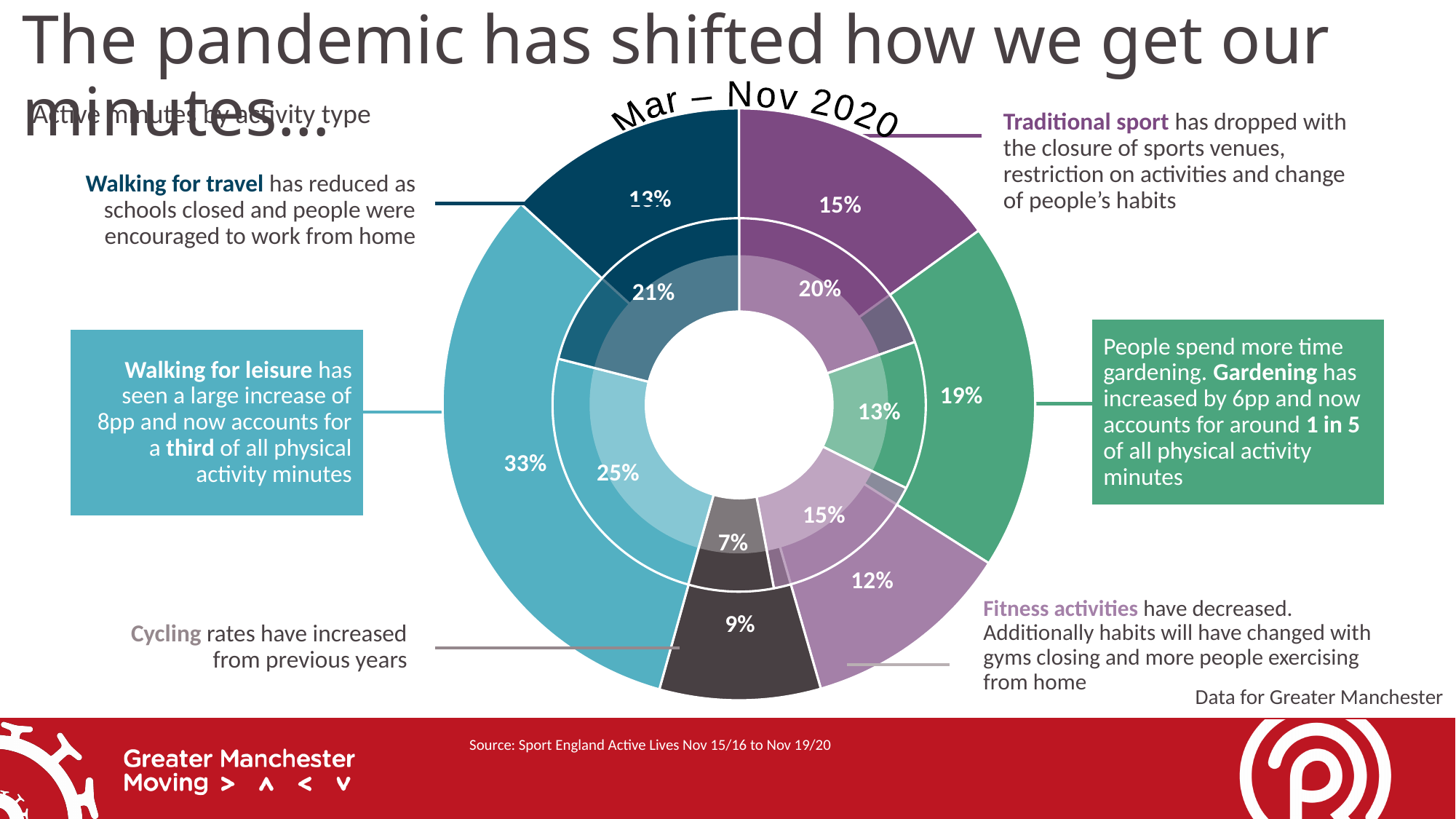
Which activity has the largest share in the outer ring (Mar – Nov 2020)? Walking for leisure What time period is labelled on the outer ring of the chart? Mar – Nov 2020 By how many percentage points does Walking for leisure's share in the outer ring (33%) exceed its share in the inner ring (25%)? 8 percentage points How many activity types are shown in the chart? 6 In the inner ring, what share of active minutes does Traditional sport account for? 20% In the outer ring (Mar – Nov 2020), what share of active minutes does Walking for leisure account for? 33% In the outer ring (Mar – Nov 2020), what share of active minutes does Gardening account for? 19% By how many percentage points does Gardening's share in the outer ring (19%) exceed its share in the inner ring (13%)? 6 percentage points What kind of chart is shown on the slide? Doughnut chart In the outer ring (Mar – Nov 2020), which has the larger share: Traditional sport or Fitness activities? Traditional sport Which activity has the smallest share in the outer ring (Mar – Nov 2020)? Cycling In the inner ring, what share of active minutes does Cycling account for? 7%